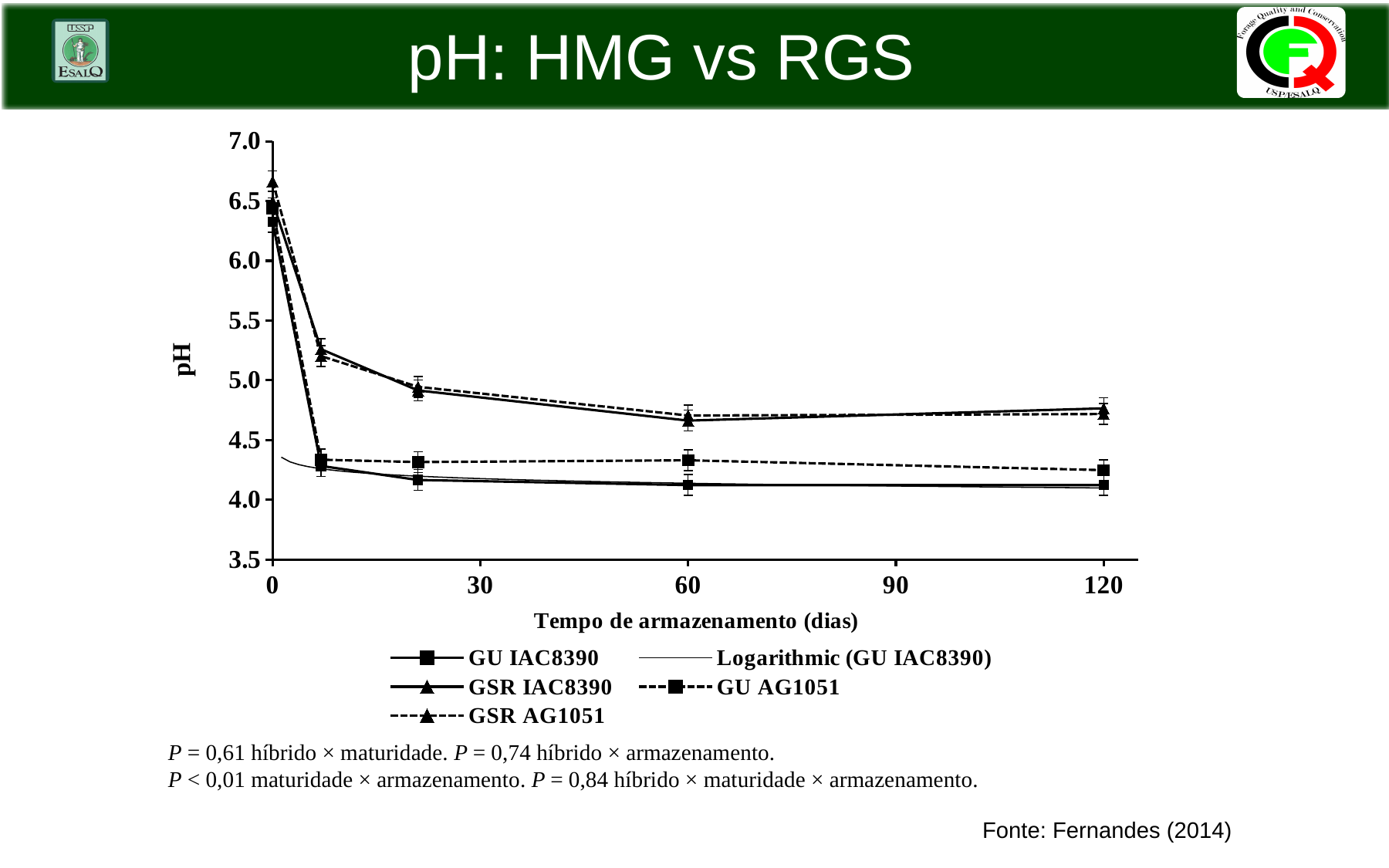
Is the value for GU IAC8390 at 60 days greater or less than 4.5? less Is the value for GU AG1051 at 120 days greater or less than 4.5? less Does the pH of GU AG1051 rise or fall as storage time increases from 0 to 120 days? fall Is the value for GSR AG1051 at 60 days greater or less than 4.5? greater What is the label of the y axis of the chart? pH What is the label of the x axis of the chart? Tempo de armazenamento (dias) What kind of chart is shown on the slide? line chart How many data points are plotted for the GU AG1051 series? 5 How many series does the chart legend list? 5 At 120 days, which has the higher pH: GSR IAC8390 or GU IAC8390? GSR IAC8390